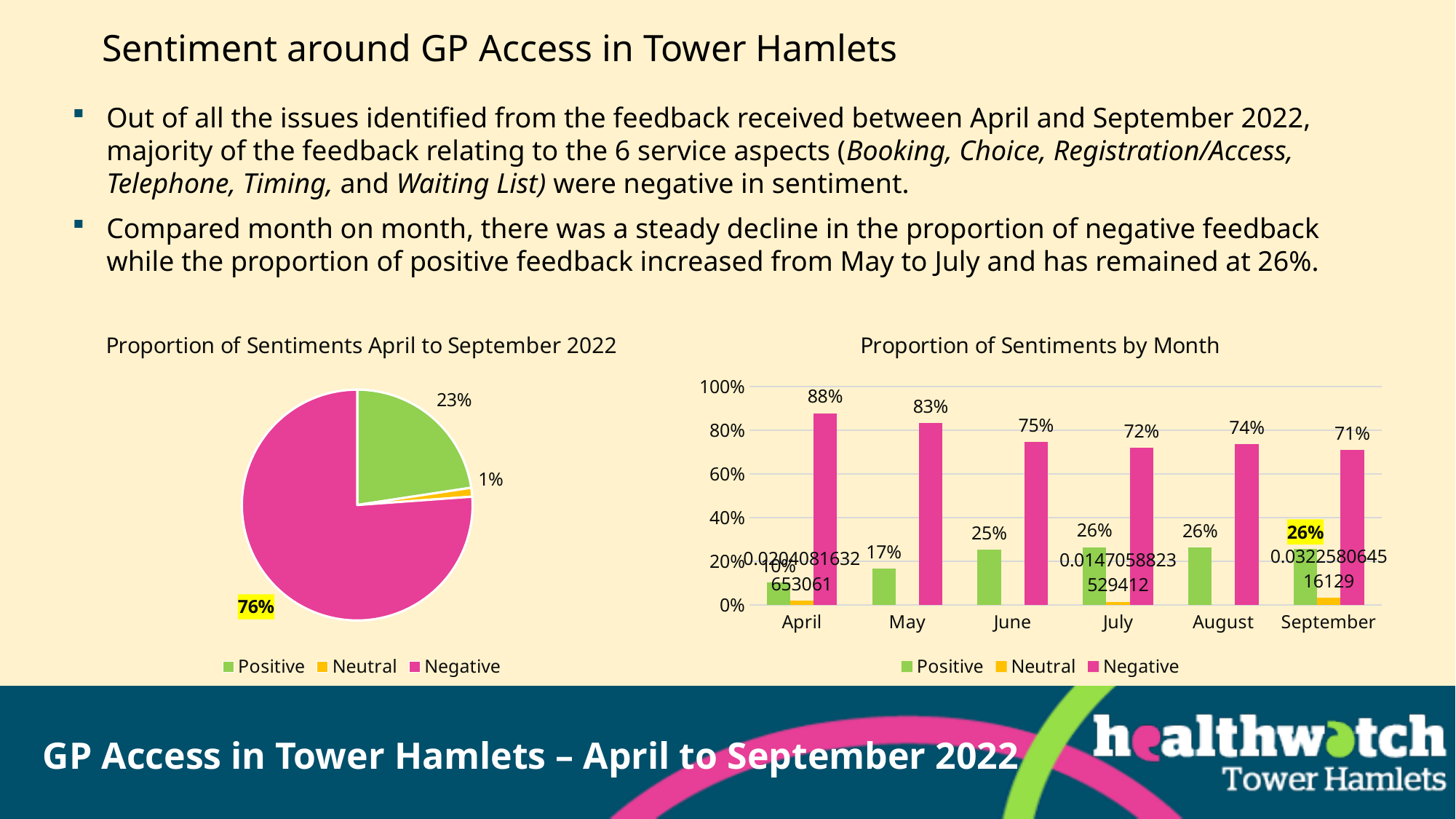
In the pie chart 'Proportion of Sentiments April to September 2022', what share is Positive? 23% In the chart 'Proportion of Sentiments by Month', is the Negative value for June larger or smaller than the Negative value for August? larger In the chart 'Proportion of Sentiments by Month', what is the Negative value for April? 88% In the chart 'Proportion of Sentiments by Month', what is the difference between the Negative values for April and September? 17% In the chart 'Proportion of Sentiments by Month', what is the Positive value for May? 17% What kind of chart is 'Proportion of Sentiments by Month'? bar chart In the pie chart 'Proportion of Sentiments April to September 2022', what share is Negative? 76% In the pie chart 'Proportion of Sentiments April to September 2022', how many series does the legend list? 3 In the chart 'Proportion of Sentiments by Month', how many months are shown on the x axis? 6 In the chart 'Proportion of Sentiments by Month', which month has the lowest Negative value? September In the chart 'Proportion of Sentiments by Month', which month has the lowest Positive value? April In the pie chart 'Proportion of Sentiments April to September 2022', which sentiment has the smallest slice? Neutral